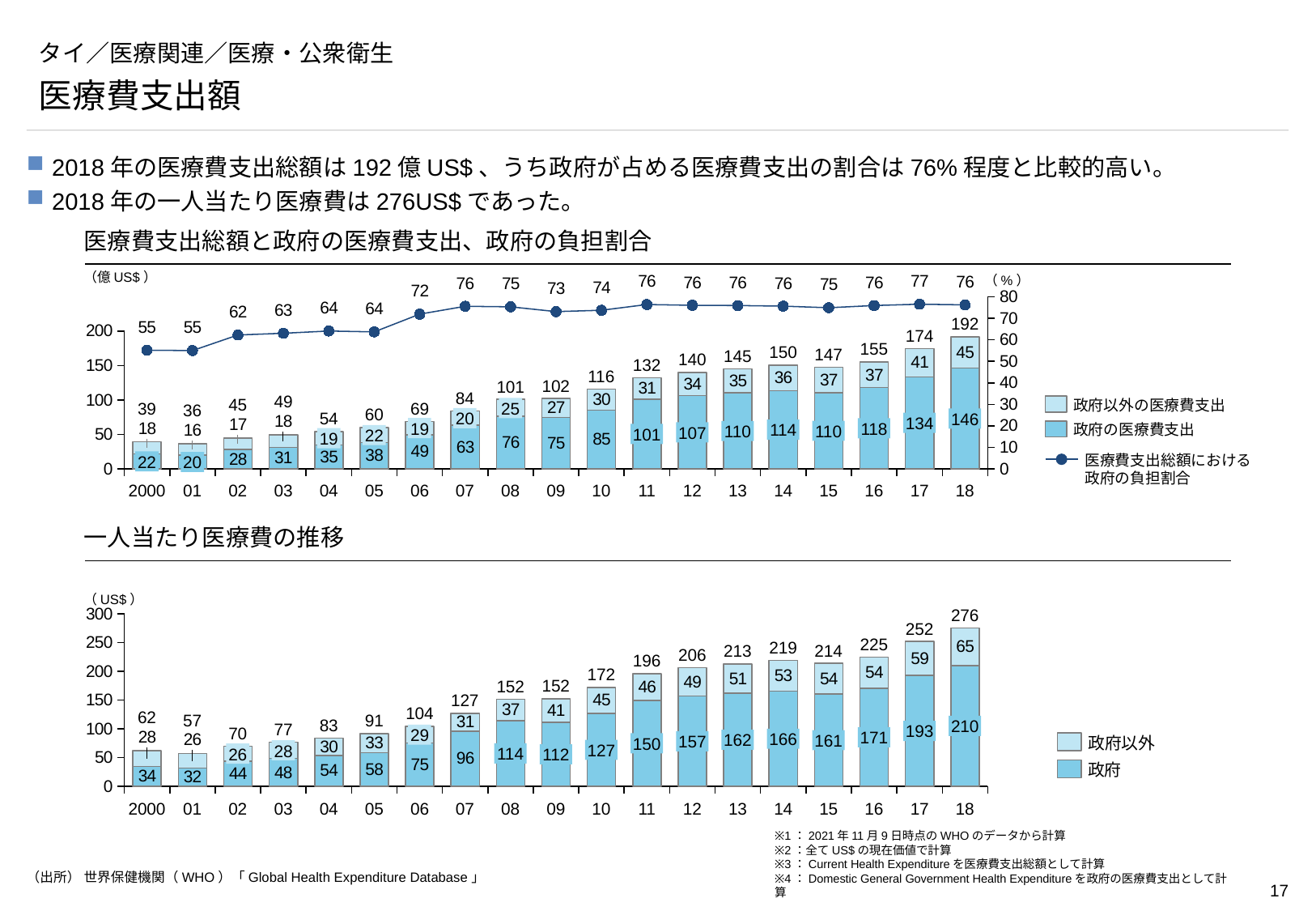
In the top chart, what is the 政府の負担割合 (%) shown for 2000? 55 In the bottom chart (一人当たり医療費の推移), what is the value of 政府 in 2018? 210 What kind of chart is the bottom chart (一人当たり医療費の推移)? Stacked bar chart In the top chart (医療費支出総額と政府の医療費支出、政府の負担割合), what is the value of 政府の医療費支出 in 2018? 146 In the top chart, what is the difference between 政府の医療費支出 in 2018 and in 2017? 12 In the top chart, which year has the highest 政府の負担割合? 17 In the bottom chart, which year has the lowest total per-capita medical expenditure? 01 In the top chart, how many entries does the legend list? 3 In the top chart, how many years are shown on the x axis? 19 In the top chart, which year has the highest total medical expenditure? 18 In the bottom chart, which is larger: the 政府 value in 2014 or in 2015? 2014 In the bottom chart, what is the value of 政府以外 in 2010? 45